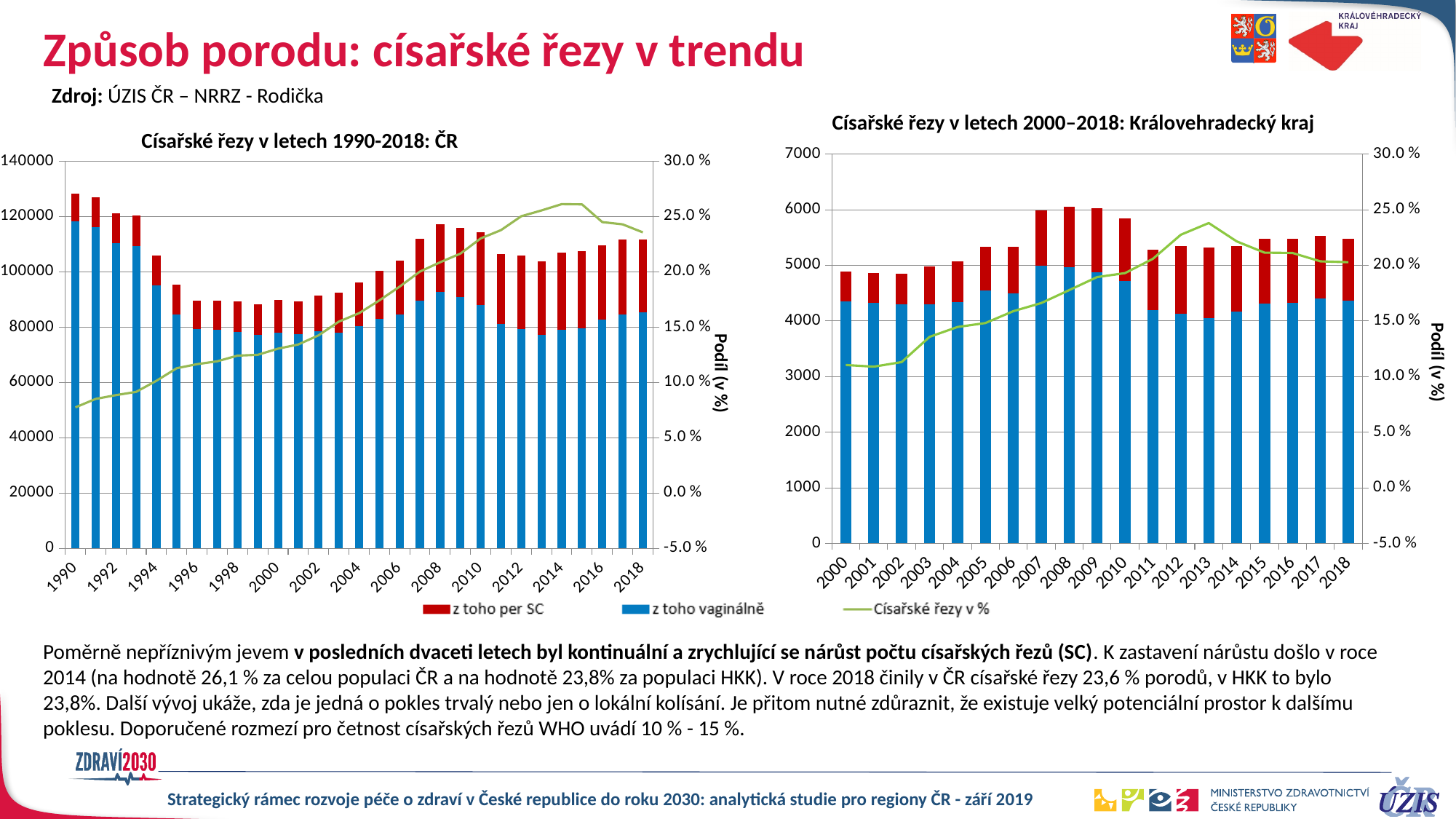
In the left chart 'Císařské řezy v letech 1990-2018: ČR', is the 'Císařské řezy v %' line value for 2014 greater or less than 25.0 %? greater Which series is shown in red in the charts' legend? z toho per SC In the left chart 'Císařské řezy v letech 1990-2018: ČR', is the 'Císařské řezy v %' line value for 1990 greater or less than 10.0 %? less In the right chart 'Císařské řezy v letech 2000–2018: Královehradecký kraj', is the total bar for 2000 greater or less than 5000? less In the right chart 'Císařské řezy v letech 2000–2018: Královehradecký kraj', does the 'Císařské řezy v %' line rise or fall from 2000 to 2013? rise How many series does the legend list for the charts? 3 What kind of chart is the left chart titled 'Císařské řezy v letech 1990-2018: ČR'? Stacked bar chart with a line In the left chart 'Císařské řezy v letech 1990-2018: ČR', which year has the highest total bar? 1990 How many years are shown on the x axis of the right chart 'Císařské řezy v letech 2000–2018: Královehradecký kraj'? 19 How many years are shown on the x axis of the left chart 'Císařské řezy v letech 1990-2018: ČR'? 29